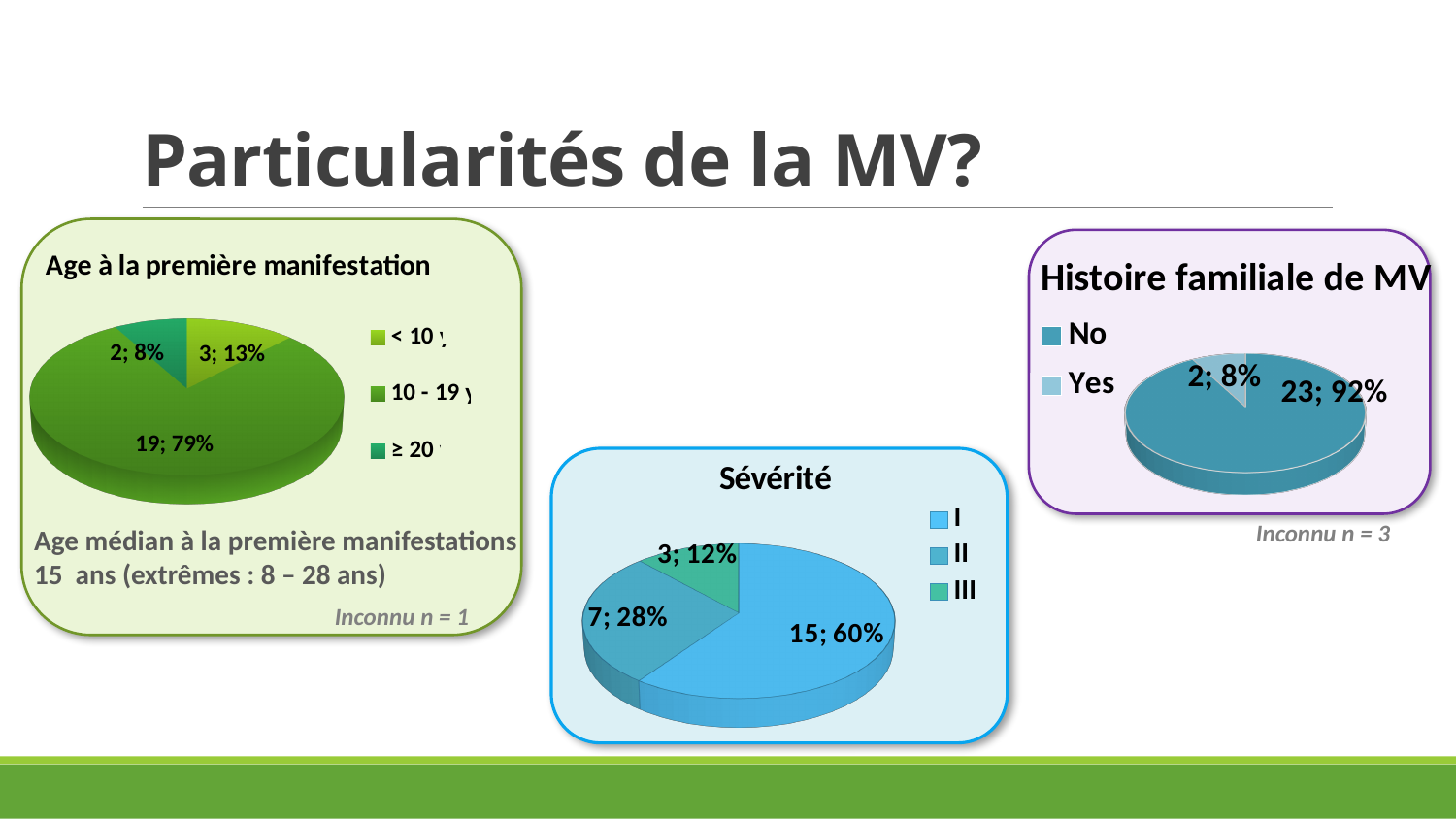
In the 'Sévérité' chart, what is the value shown for category I? 15; 60% In the 'Sévérité' chart, how many series does the legend list? 3 In the 'Histoire familiale de MV' chart, what is the value shown for 'No'? 23; 92% In the 'Histoire familiale de MV' chart, what is the difference in count between 'No' and 'Yes'? 21 In the 'Sévérité' chart, what is the value shown for category II? 7; 28% What type of chart is the 'Sévérité' chart? Pie chart In the 'Sévérité' chart, which category has the smallest slice? III In the 'Age à la première manifestation' chart, which category has the largest slice? 10 - 19 In the 'Sévérité' chart, what share of the pie does category I represent? 60% In the 'Age à la première manifestation' chart, which is larger, the '< 10' slice or the '≥ 20' slice? < 10 In the 'Age à la première manifestation' chart, what is the value shown for the '10 - 19' category? 19; 79% In the 'Histoire familiale de MV' chart, what is the value shown for 'Yes'? 2; 8%